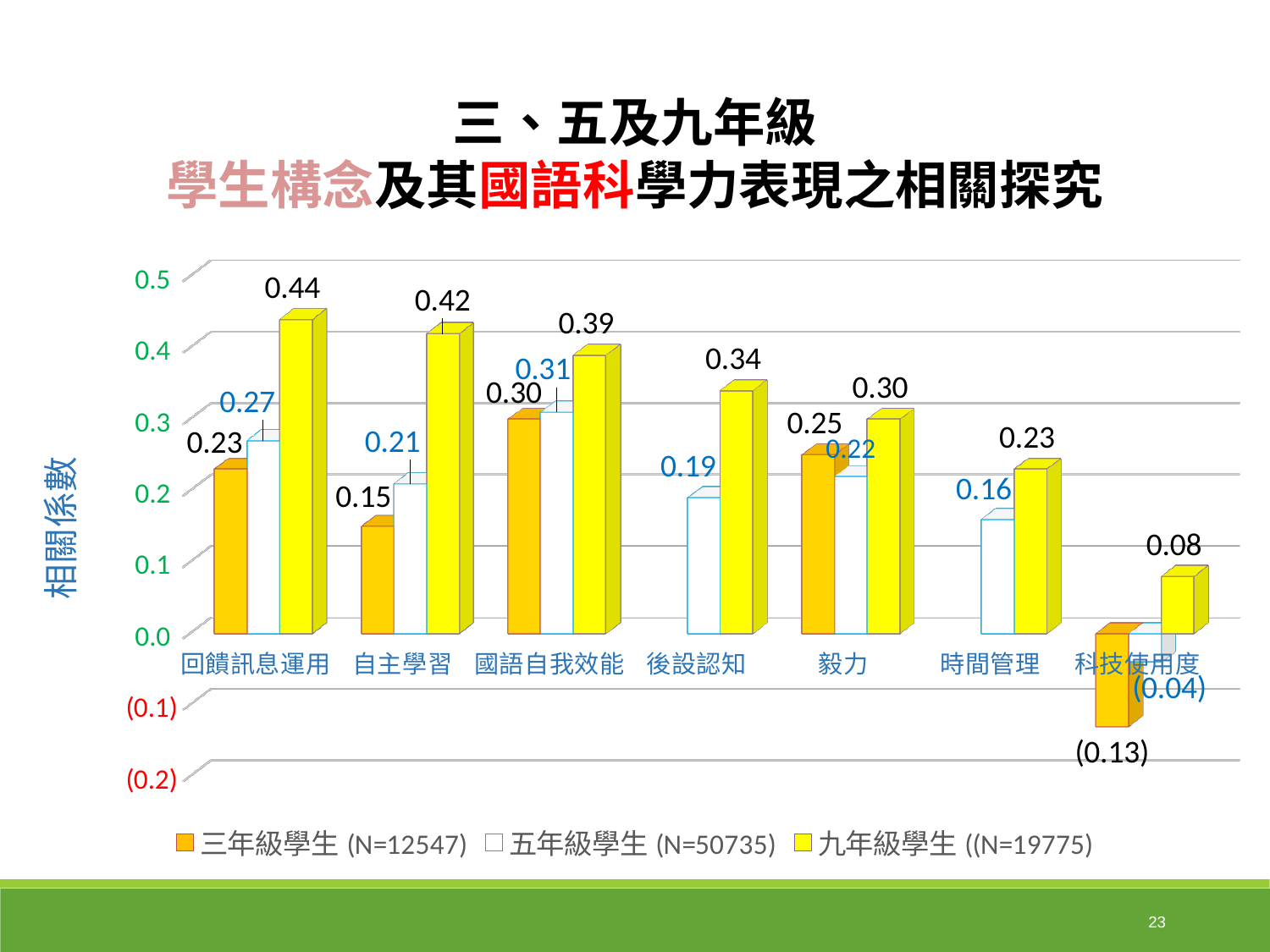
Which category has the lowest value for 九年級學生? 科技使用度 In the 毅力 category, which is larger: the value for 三年級學生 or for 五年級學生? 三年級學生 What is the correlation coefficient for 九年級學生 in the 回饋訊息運用 category? 0.44 Which category has the highest value for 九年級學生? 回饋訊息運用 What is the value for 三年級學生 in the 科技使用度 category? (0.13) How many series does the legend list? 3 How many categories are shown on the x axis? 7 Do the values for 九年級學生 rise or fall from left to right across the categories? fall What is the value for 五年級學生 in the 時間管理 category? 0.16 What is the difference between the 九年級學生 and 三年級學生 values in the 回饋訊息運用 category? 0.21 What is the value for 五年級學生 in the 科技使用度 category? (0.04) What kind of chart is shown on the slide? bar chart